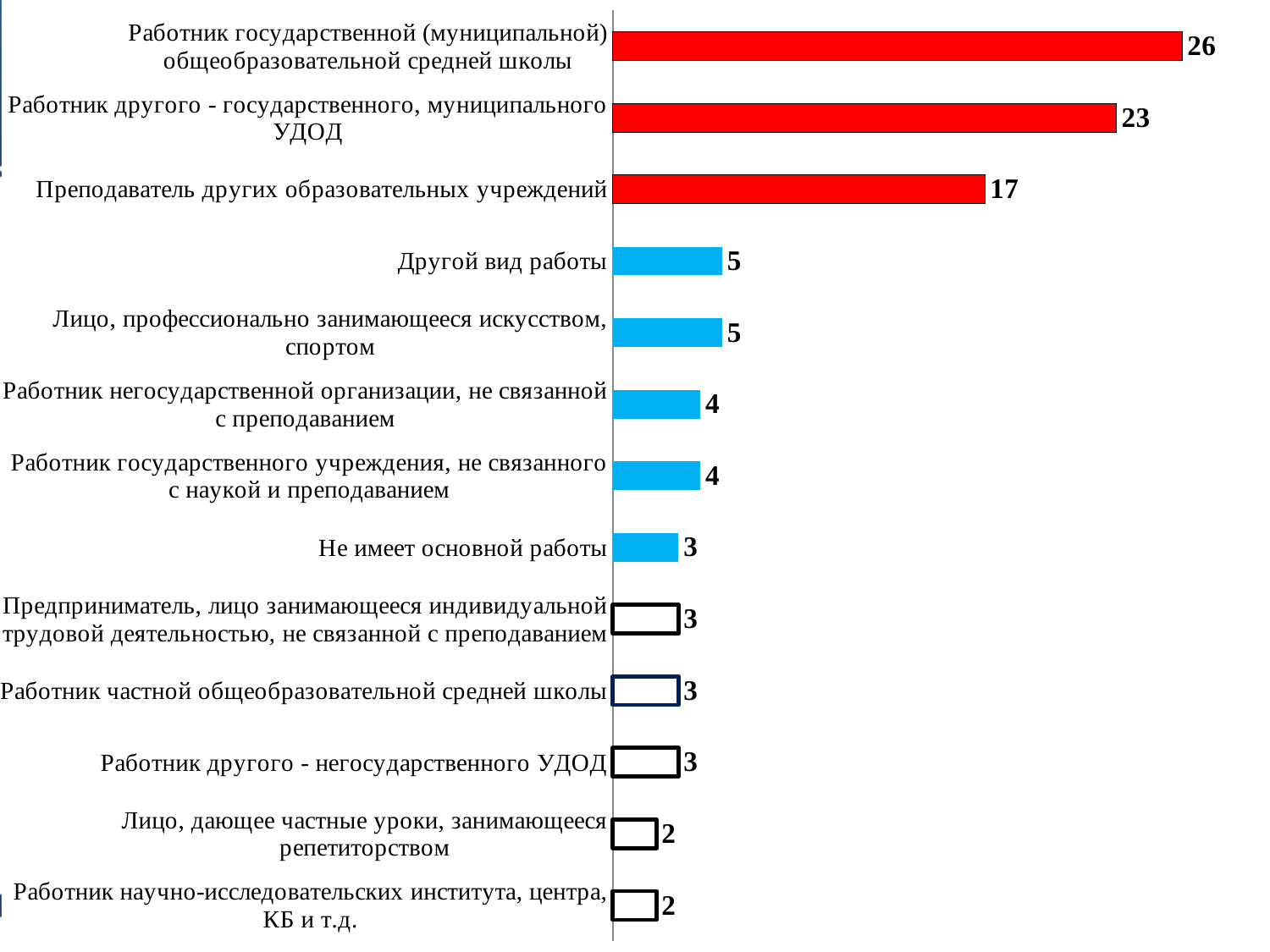
What is the value for "Лицо, дающее частные уроки, занимающееся репетиторством"? 2 What is the difference between the values for "Работник государственной (муниципальной) общеобразовательной средней школы" and "Работник другого - государственного, муниципального УДОД"? 3 What is the difference between the values for "Преподаватель других образовательных учреждений" and "Другой вид работы"? 12 What is the value for "Преподаватель других образовательных учреждений"? 17 What is the value for "Работник государственной (муниципальной) общеобразовательной средней школы"? 26 What is the lowest value shown on the chart? 2 What colour are the three bars with the highest values? Red How many categories are shown on the chart? 13 Which category has the highest value? Работник государственной (муниципальной) общеобразовательной средней школы What is the value for "Не имеет основной работы"? 3 What kind of chart is shown on the slide? Bar chart Which is larger: the value for "Работник другого - государственного, муниципального УДОД" or the value for "Преподаватель других образовательных учреждений"? Работник другого - государственного, муниципального УДОД